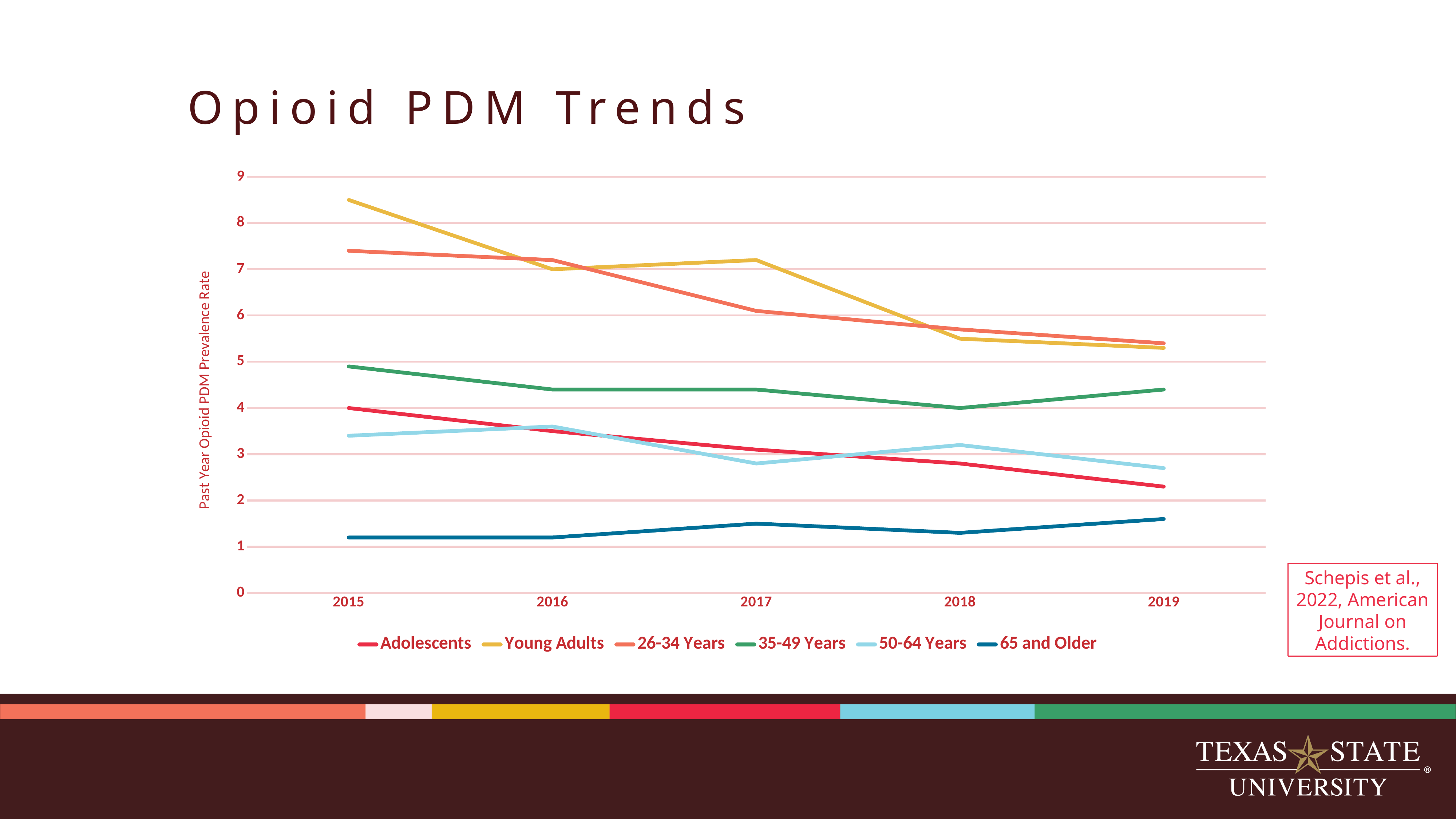
What is the title of the chart? Opioid PDM Trends How many series does the legend list? 6 Is the value for Young Adults in 2015 greater or less than 8? greater What kind of chart is shown on the slide? line chart Is the value for Adolescents in 2019 greater or less than 3? less What is the label on the y axis? Past Year Opioid PDM Prevalence Rate How many years are shown on the x axis? 5 Which age group has the lowest prevalence rate in 2019? 65 and Older Which age group has the highest prevalence rate in 2015? Young Adults Does the Adolescents line rise or fall from 2015 to 2019? fall In 2017, which is larger: the value for Young Adults or the value for 26-34 Years? Young Adults Is the value for 65 and Older in 2019 greater or less than 2? less